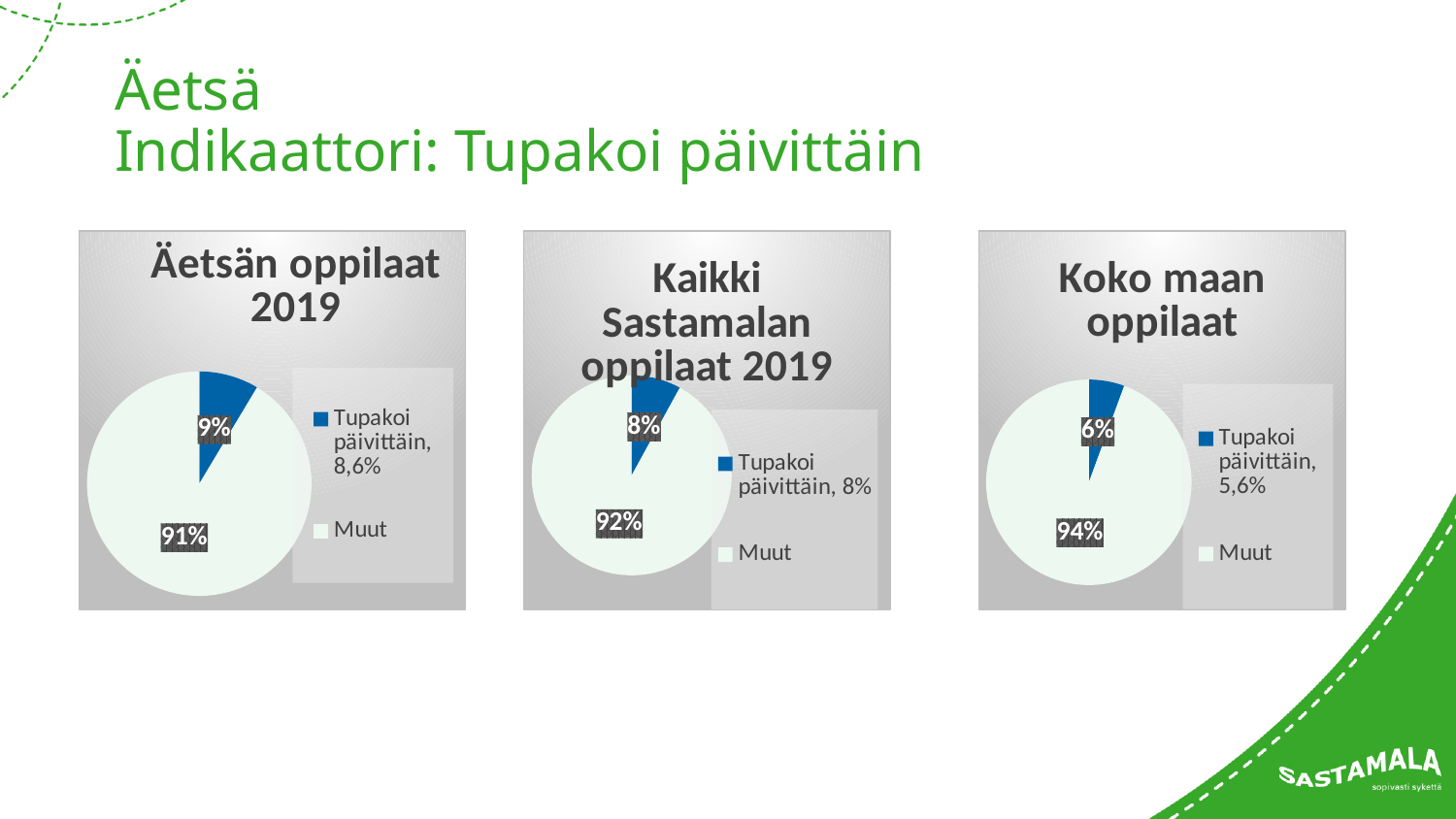
Is the "Tupakoi päivittäin" slice larger in the "Äetsän oppilaat 2019" chart or in the "Koko maan oppilaat" chart? Äetsän oppilaat 2019 How many slices does the "Kaikki Sastamalan oppilaat 2019" pie chart have? 2 In the "Äetsän oppilaat 2019" chart, what percentage is shown on the "Muut" slice? 91% In the "Koko maan oppilaat" chart, what percentage is shown on the "Tupakoi päivittäin" slice? 6% In the "Koko maan oppilaat" chart, what value is given for "Tupakoi päivittäin" in the legend? 5,6% What kind of chart is "Äetsän oppilaat 2019"? pie chart In the "Koko maan oppilaat" chart, what percentage is shown on the "Muut" slice? 94% In the "Äetsän oppilaat 2019" chart, which slice is the smallest? Tupakoi päivittäin In the "Kaikki Sastamalan oppilaat 2019" chart, what percentage is shown on the "Tupakoi päivittäin" slice? 8% In the "Kaikki Sastamalan oppilaat 2019" chart, what percentage is shown on the "Muut" slice? 92% In the "Äetsän oppilaat 2019" chart, what percentage is shown on the "Tupakoi päivittäin" slice? 9% In the "Koko maan oppilaat" chart, which slice is the largest? Muut